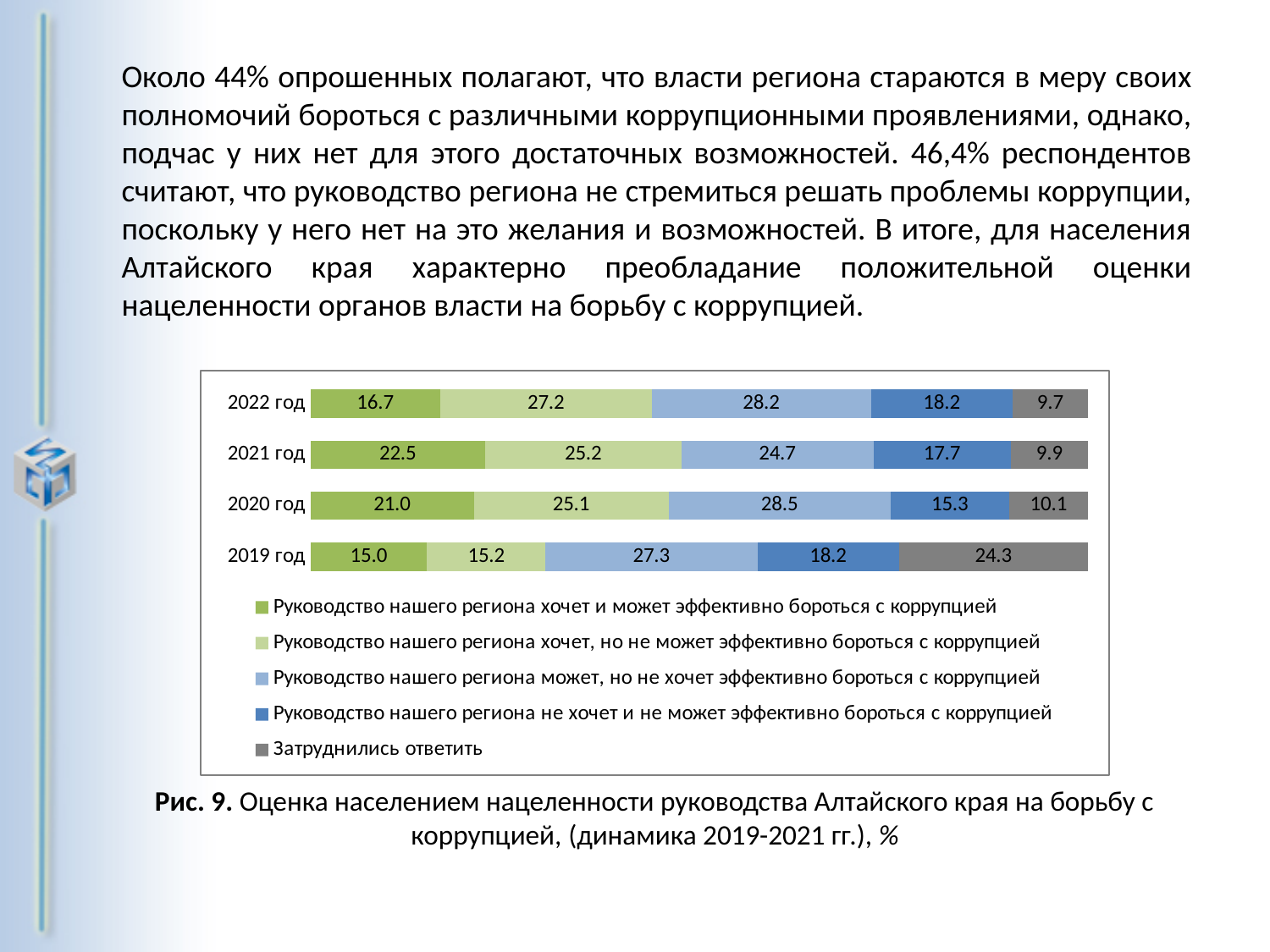
What is the total of the stacked bar for 2021 год? 100.0 Which year has the larger value for 'Руководство нашего региона может, но не хочет эффективно бороться с коррупцией': 2020 год or 2022 год? 2020 год What is the difference between the 'Затруднились ответить' values for 2019 год and 2022 год? 14.6 What is the value for 'Руководство нашего региона не хочет и не может эффективно бороться с коррупцией' in 2020 год? 15.3 Does the value for 'Затруднились ответить' rise or fall from 2019 год to 2022 год? Fall In which year is the value for 'Затруднились ответить' the lowest? 2022 год In which year is the value for 'Руководство нашего региона хочет и может эффективно бороться с коррупцией' the highest? 2021 год How many series does the legend list? 5 What is the value for 'Руководство нашего региона хочет и может эффективно бороться с коррупцией' in 2022 год? 16.7 What is the value for 'Затруднились ответить' in 2019 год? 24.3 How many years (categories) are shown in the chart? 4 What kind of chart is shown on the slide? Stacked bar chart